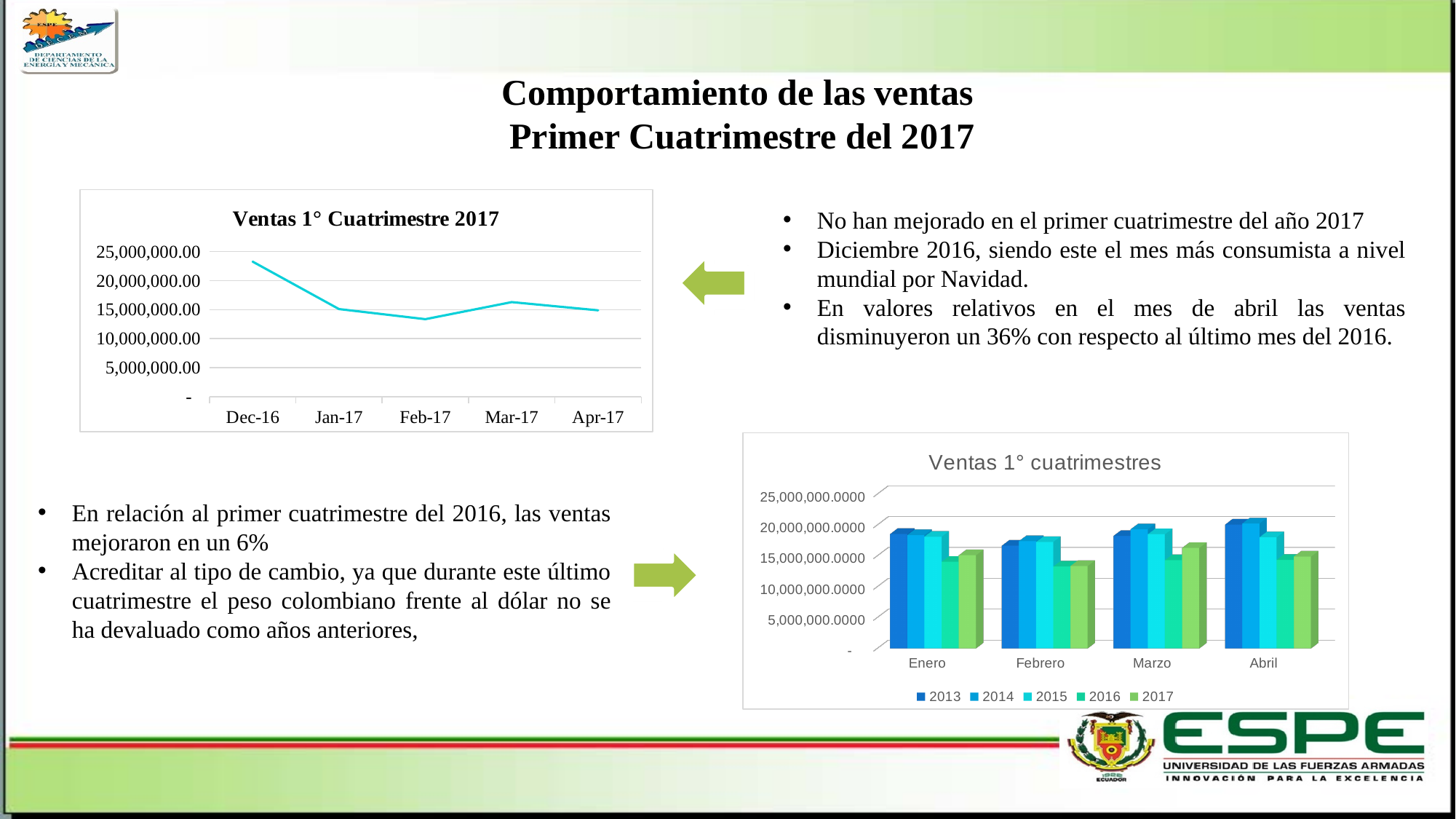
What kind of chart is the 'Ventas 1° Cuatrimestre 2017' chart? line chart In the 'Ventas 1° Cuatrimestre 2017' chart, is the value for Dec-16 greater or less than 20,000,000.00? greater In the 'Ventas 1° Cuatrimestre 2017' chart, which month has the lowest value? Feb-17 In the 'Ventas 1° Cuatrimestre 2017' chart, which month has the highest value? Dec-16 In the 'Ventas 1° Cuatrimestre 2017' chart, do the values rise or fall from Dec-16 to Jan-17? fall What kind of chart is the 'Ventas 1° cuatrimestres' chart? bar chart In the 'Ventas 1° cuatrimestres' chart, which month has the lowest 2017 value? Febrero In the 'Ventas 1° Cuatrimestre 2017' chart, is the value for Feb-17 greater or less than 15,000,000.00? less How many series does the legend of the 'Ventas 1° cuatrimestres' chart list? 5 In the 'Ventas 1° cuatrimestres' chart, is the 2017 value for Febrero greater or less than 15,000,000.0000? less In the 'Ventas 1° cuatrimestres' chart, which is larger for Abril: 2013 or 2017? 2013 In the 'Ventas 1° Cuatrimestre 2017' chart, how many months are plotted on the x axis? 5